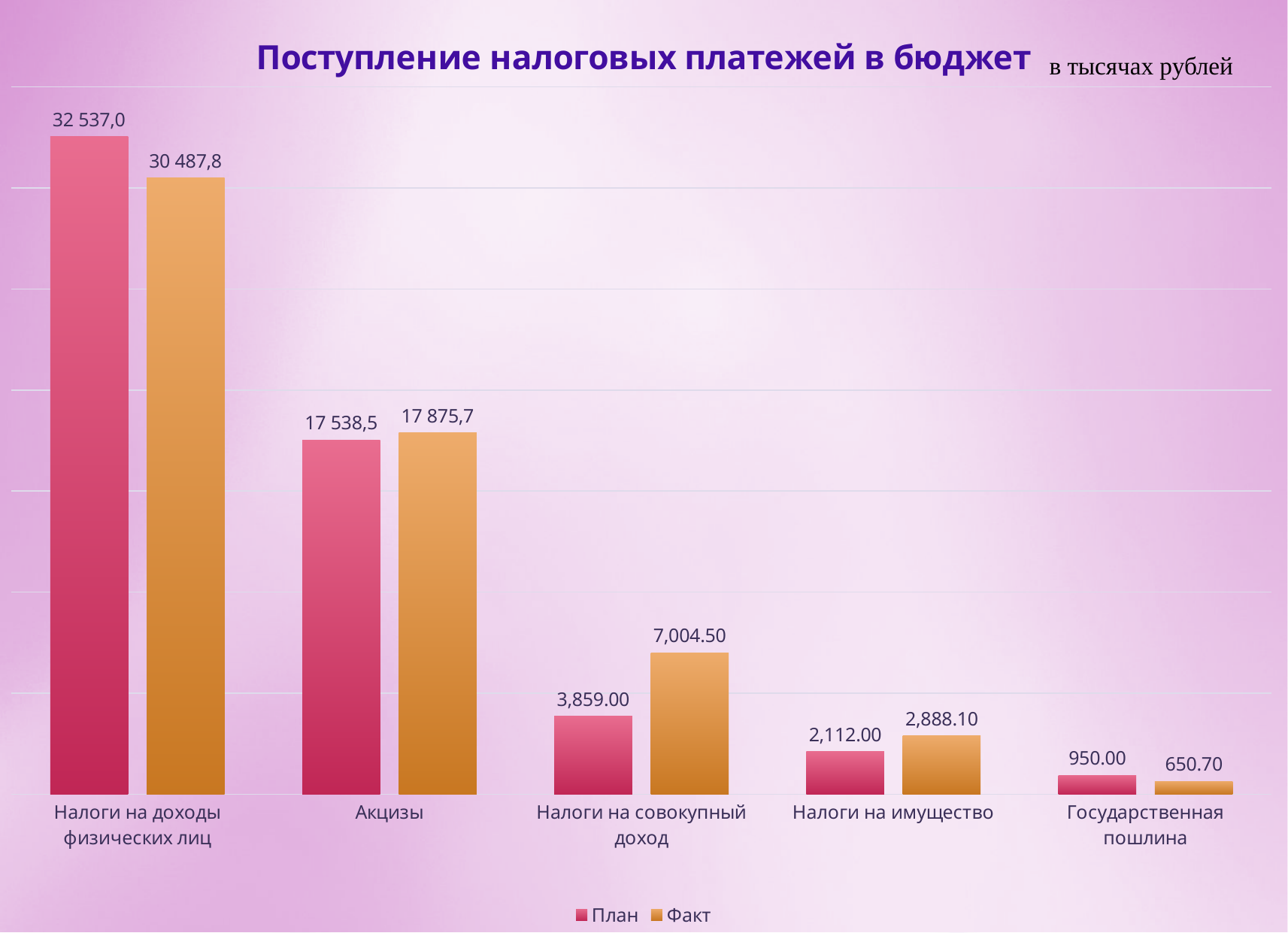
What type of chart is shown on the slide? Bar chart Which category has the lowest План value? Государственная пошлина For Акцизы, which is larger: the План value or the Факт value? Факт How many categories are shown on the x axis? 5 What is the difference between the План and Факт values for Государственная пошлина? 299.30 What is the difference between the Факт and План values for Налоги на совокупный доход? 3,145.50 What is the Факт value for Государственная пошлина? 650.70 What is the План value for Налоги на доходы физических лиц? 32 537,0 Which category has the highest Факт value? Налоги на доходы физических лиц What is the План value for Налоги на имущество? 2,112.00 What is the Факт value for Налоги на совокупный доход? 7,004.50 How many series does the legend list? 2